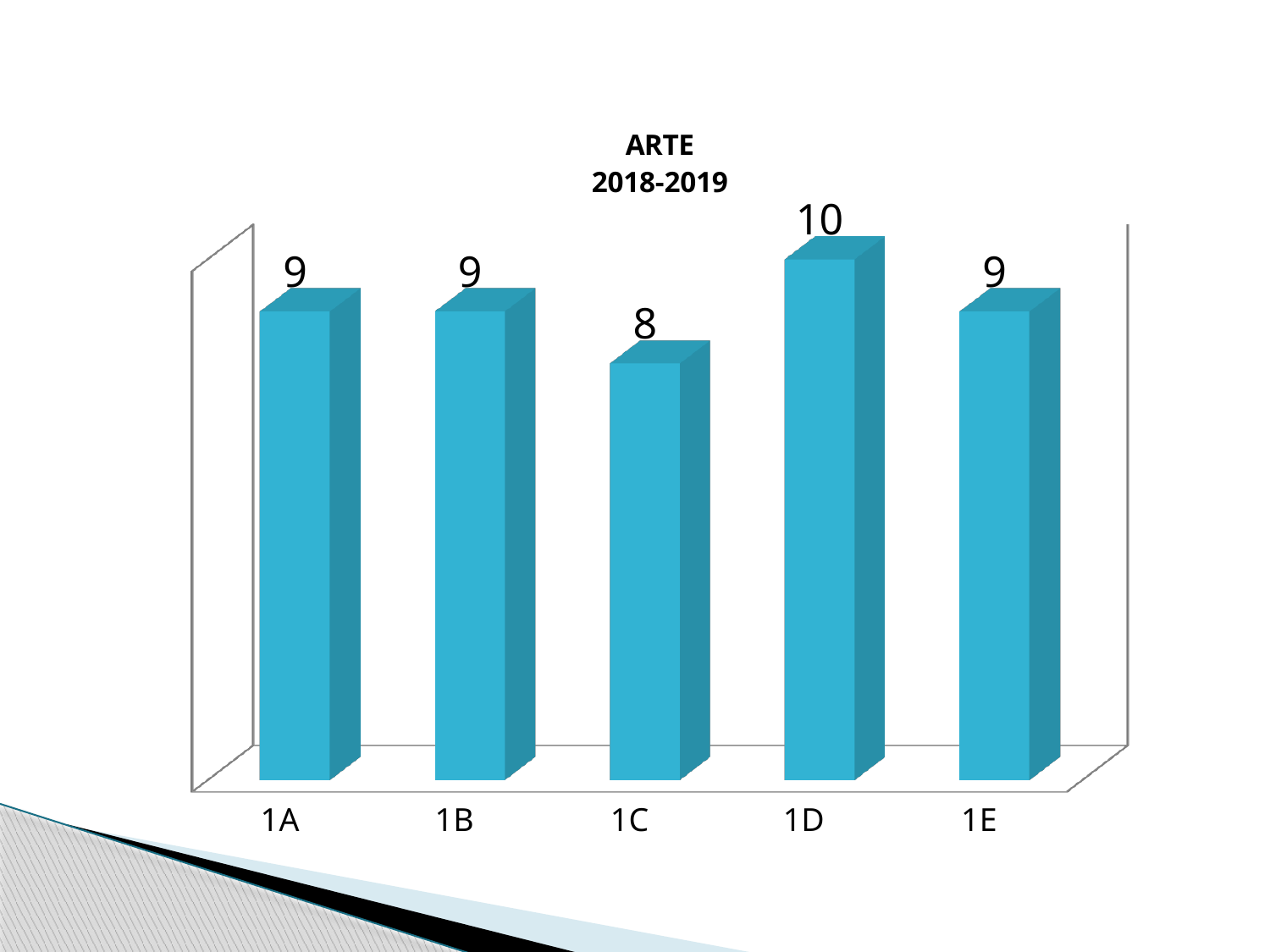
Which category has the lowest value? 1C What kind of chart is this? bar chart What is the title of the chart? ARTE 2018-2019 What is the value for 1A? 9 What is the difference between the values for 1D and 1C? 2 Which is larger, the value for 1D or the value for 1E? 1D What is the difference between the values for 1B and 1C? 1 Which category has the highest value? 1D What is the value for 1D? 10 How many categories are shown on the x axis? 5 What is the value for 1C? 8 What is the value for 1E? 9